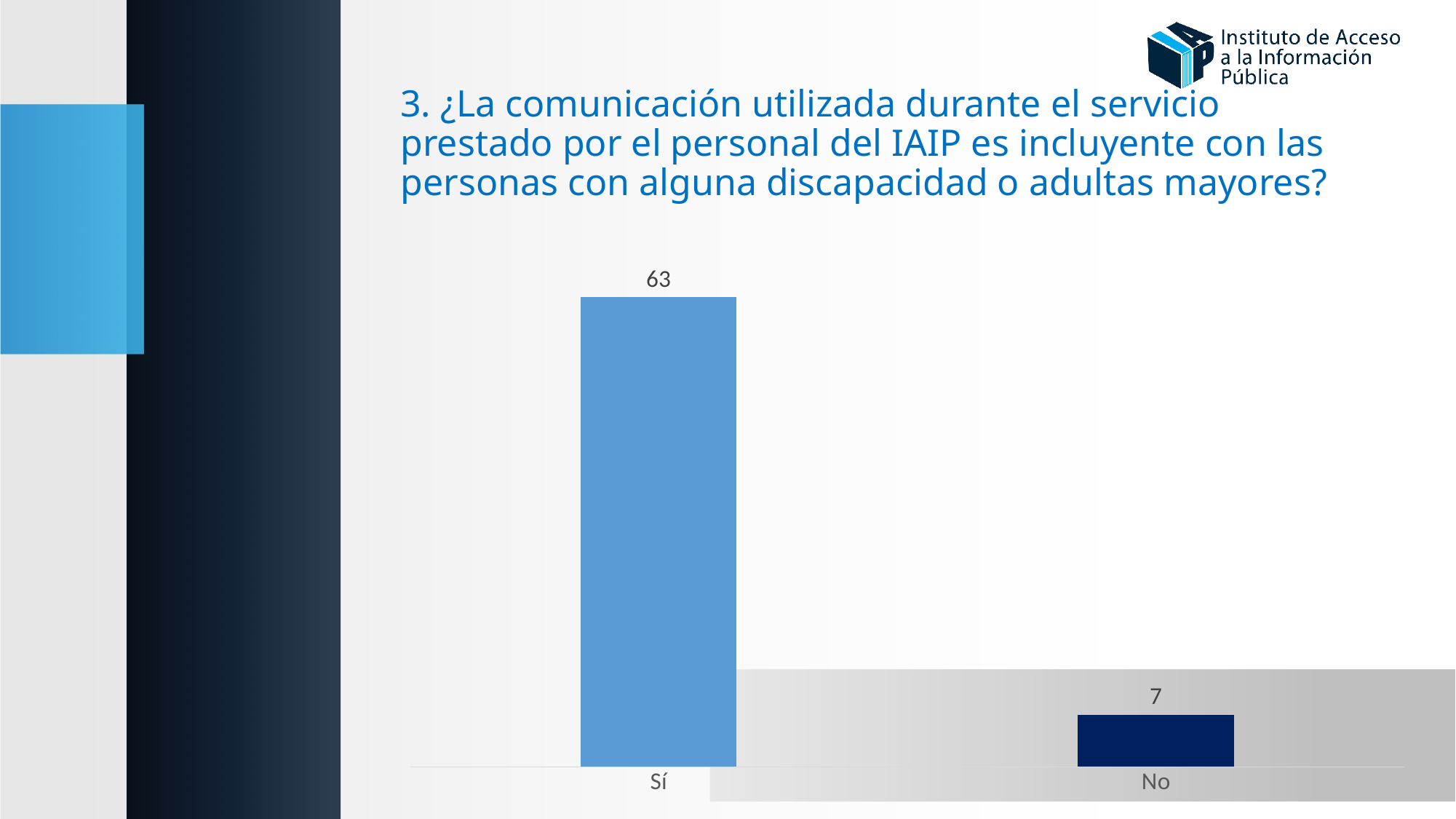
What kind of chart is shown on the slide? Bar chart What question number does the chart's title refer to? 3 How many categories are shown in the chart? 2 What is the value for "No"? 7 What is the value for "Sí"? 63 What is the difference between the values for "Sí" and "No"? 56 Which category has the lowest value? No Do the values rise or fall from "Sí" to "No"? Fall Which is larger, the value for "Sí" or the value for "No"? Sí What colour is the bar for "No"? Dark navy blue Which category has the highest value? Sí What is the total of the values for "Sí" and "No"? 70